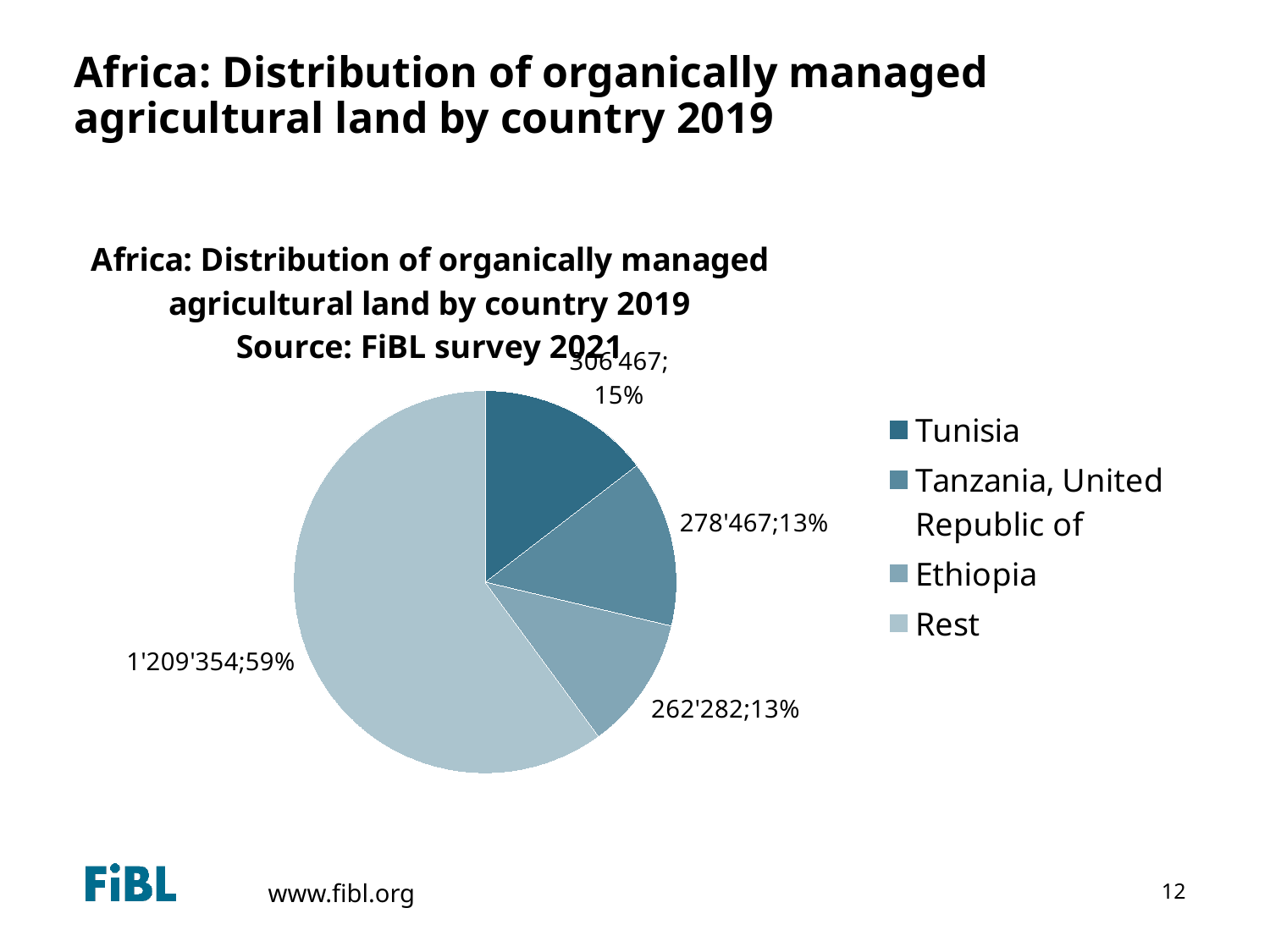
What is the difference between the values for Tanzania, United Republic of and Ethiopia? 16'185 Which slice of the pie chart is the largest? Rest Which is larger, the value for Tanzania, United Republic of or the value for Ethiopia? Tanzania, United Republic of Which named country has the smallest slice in the pie chart? Ethiopia What is the value shown for the Rest slice? 1'209'354 What kind of chart is shown on the slide? pie chart What share of the pie does the Rest slice represent? 59% What is the value shown for Ethiopia? 262'282 What is the value shown for Tanzania, United Republic of? 278'467 What share of the pie does Tunisia represent? 15% How many slices does the pie chart have? 4 How many entries does the legend of the pie chart list? 4